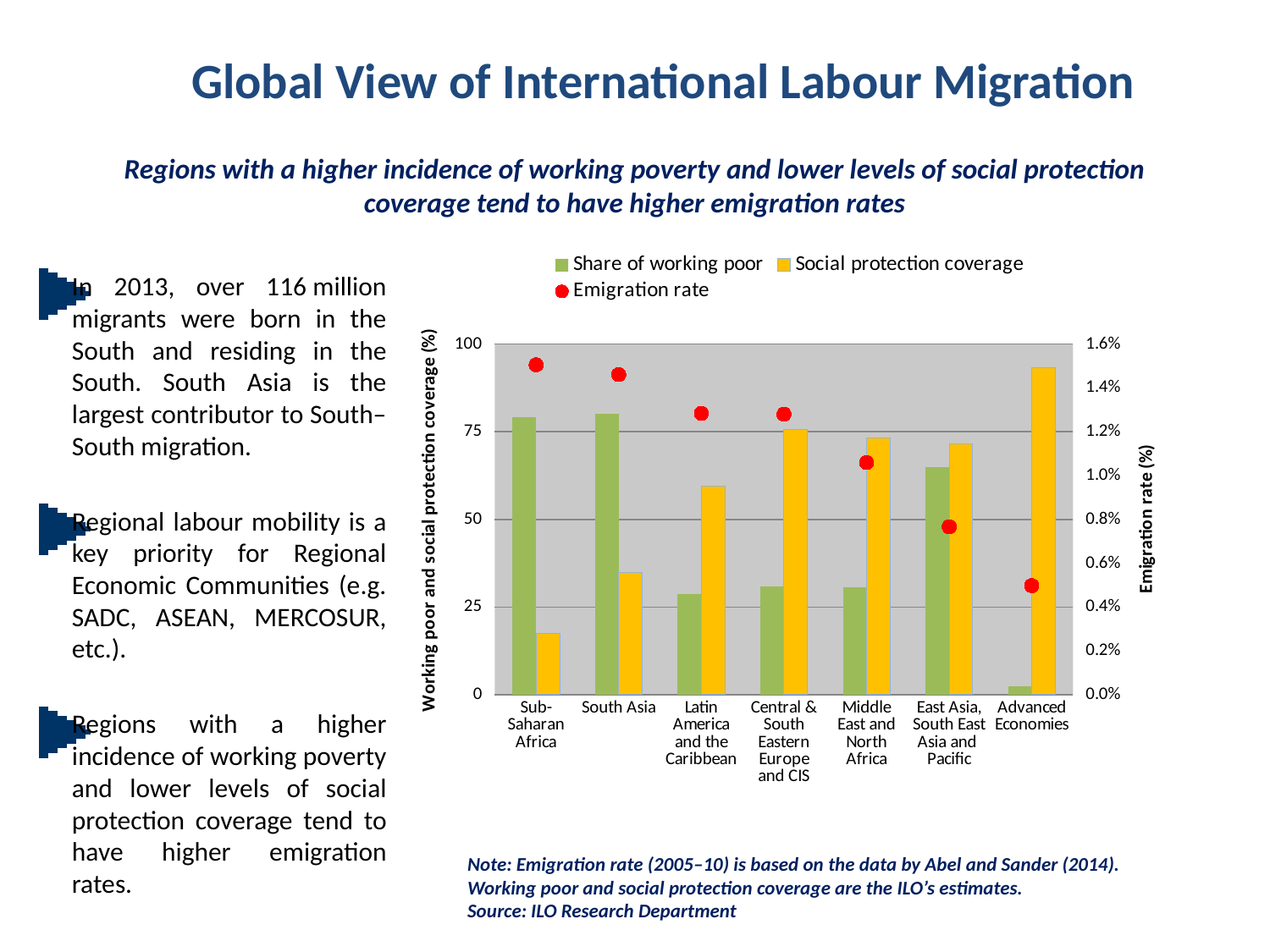
How many series does the chart legend list? 3 How many regions are shown on the x axis of the chart? 7 Is the emigration rate for Middle East and North Africa greater or less than 1.2%? less Which region has a higher emigration rate: Sub-Saharan Africa or East Asia, South East Asia and Pacific? Sub-Saharan Africa Which region has the highest social protection coverage? Advanced Economies What colour are the bars for the Social protection coverage series? Yellow Which region has the lowest emigration rate? Advanced Economies Is the social protection coverage for South Asia greater or less than 50? less Which is larger for Latin America and the Caribbean: the share of working poor or the social protection coverage? Social protection coverage Which region has the lowest share of working poor? Advanced Economies Is the share of working poor for Sub-Saharan Africa greater or less than 75? greater Which region has the lowest social protection coverage? Sub-Saharan Africa